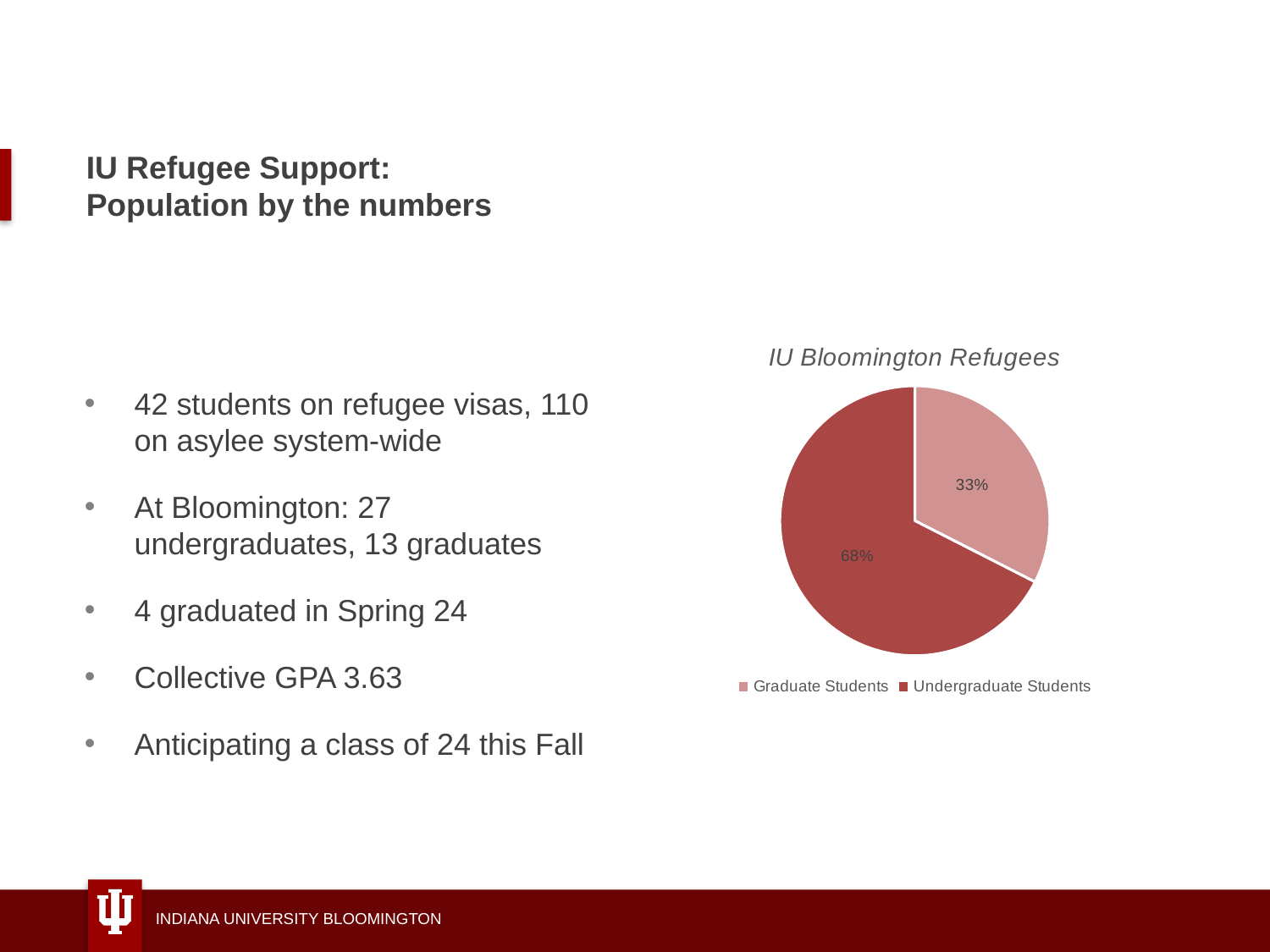
Which category has the smallest share of the pie? Graduate Students Which legend entry is shown in the darker red colour? Undergraduate Students What share of the pie does the Undergraduate Students slice represent? 68% How many entries does the legend list? 2 What type of chart is shown on the slide? pie chart What is the title of the chart? IU Bloomington Refugees How many slices does the pie chart have? 2 Which category has the largest share of the pie? Undergraduate Students What is the difference in percentage points between the Undergraduate Students and Graduate Students slices? 35 What percentage of the pie is Graduate Students? 33% What percentage of the pie is Undergraduate Students? 68% Which is larger, the share for Graduate Students or for Undergraduate Students? Undergraduate Students